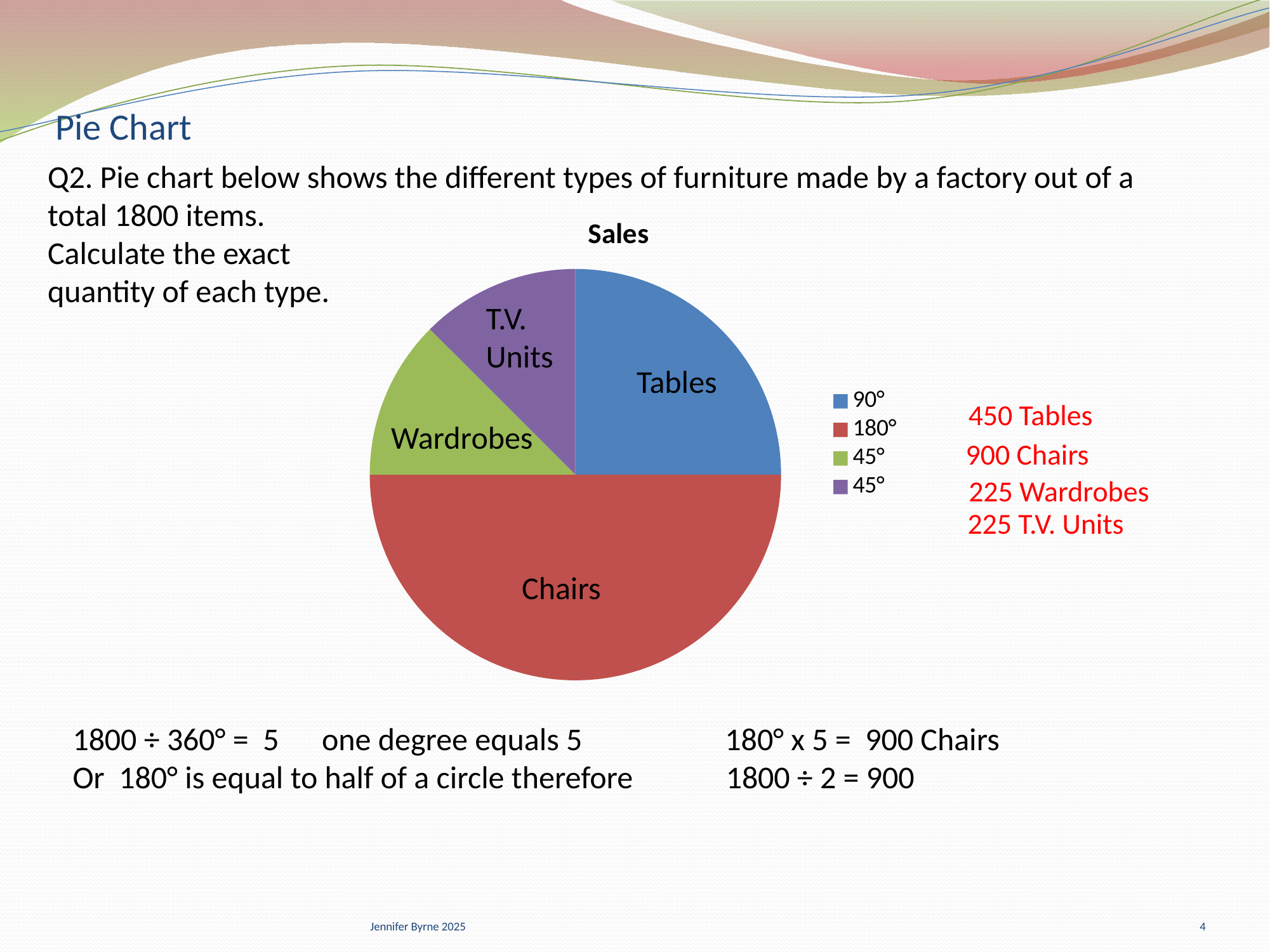
What colour is the Wardrobes slice in the pie chart? Green Which slice is larger, Tables or Chairs? Chairs What share of the whole pie does the Chairs slice take up? 50% How many degrees does the Tables slice represent according to the legend? 90° What is the title of the pie chart? Sales How many degrees does the Chairs slice represent according to the legend? 180° How many slices does the pie chart have? 4 What is the difference in degrees between the Chairs slice and the Tables slice? 90° Which category has the largest slice in the pie chart? Chairs What share of the whole pie does the Tables slice take up? 25% How many entries does the legend of the pie chart list? 4 What kind of chart is shown on the slide? Pie chart